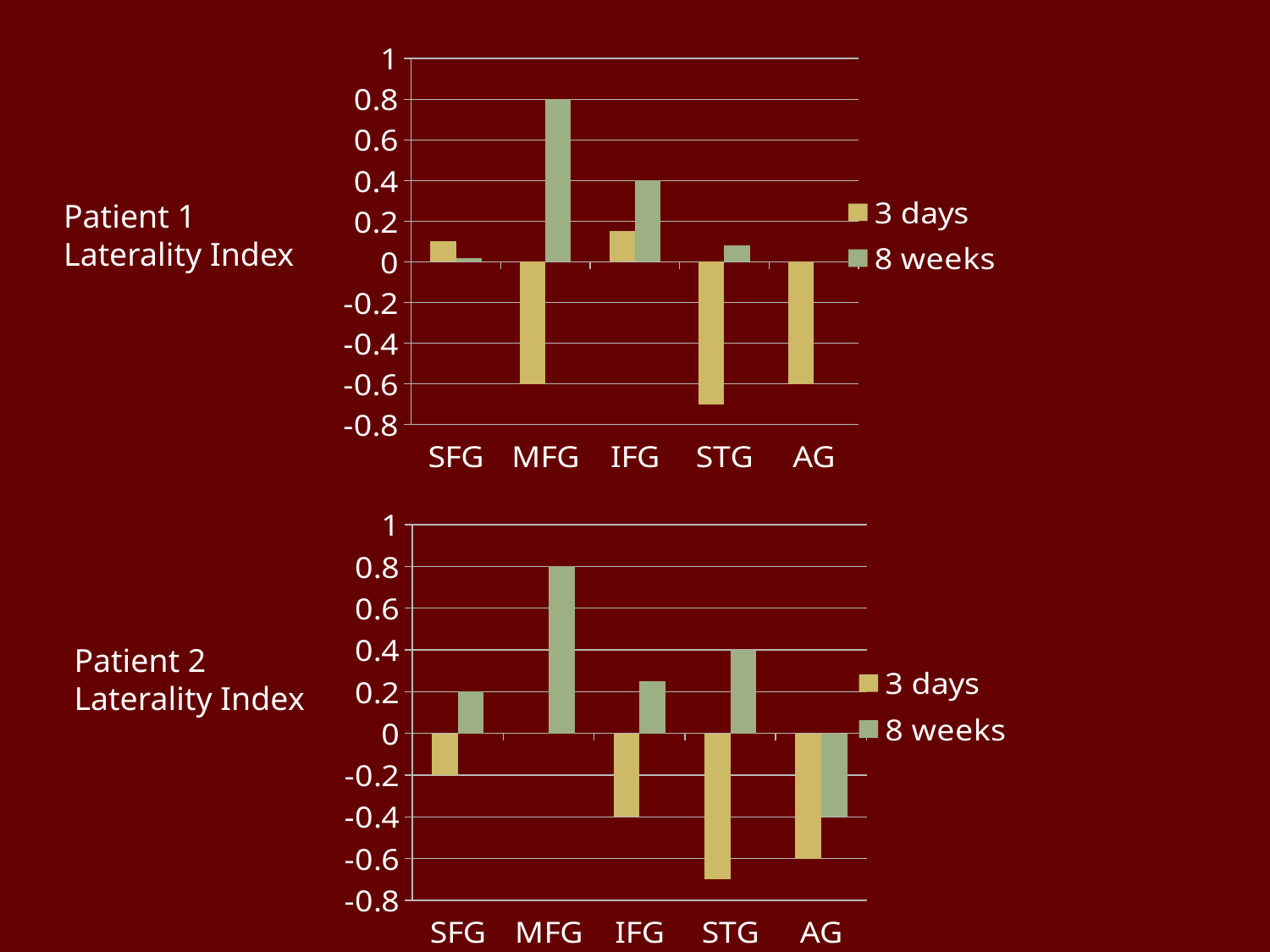
In the Patient 2 Laterality Index chart, which category has the lowest 3 days value? STG In the Patient 1 Laterality Index chart, which category has the highest 8 weeks value? MFG In the Patient 1 Laterality Index chart, what is the 8 weeks value for MFG? 0.8 How many categories are shown on the x axis of the Patient 1 Laterality Index chart? 5 What are the two legend entries in the Patient 1 Laterality Index chart? 3 days and 8 weeks In the Patient 1 Laterality Index chart, which category has the lowest 3 days value? STG In the Patient 2 Laterality Index chart, what is the 8 weeks value for STG? 0.4 In the Patient 1 Laterality Index chart, is the 3 days value for STG greater or less than -0.6? less What kind of chart is the Patient 1 Laterality Index chart? bar chart In the Patient 2 Laterality Index chart, is the 3 days value for SFG greater or less than 0? less In the Patient 2 Laterality Index chart, which is larger for AG: the 3 days value or the 8 weeks value? 8 weeks How many series does the legend of the Patient 2 Laterality Index chart list? 2